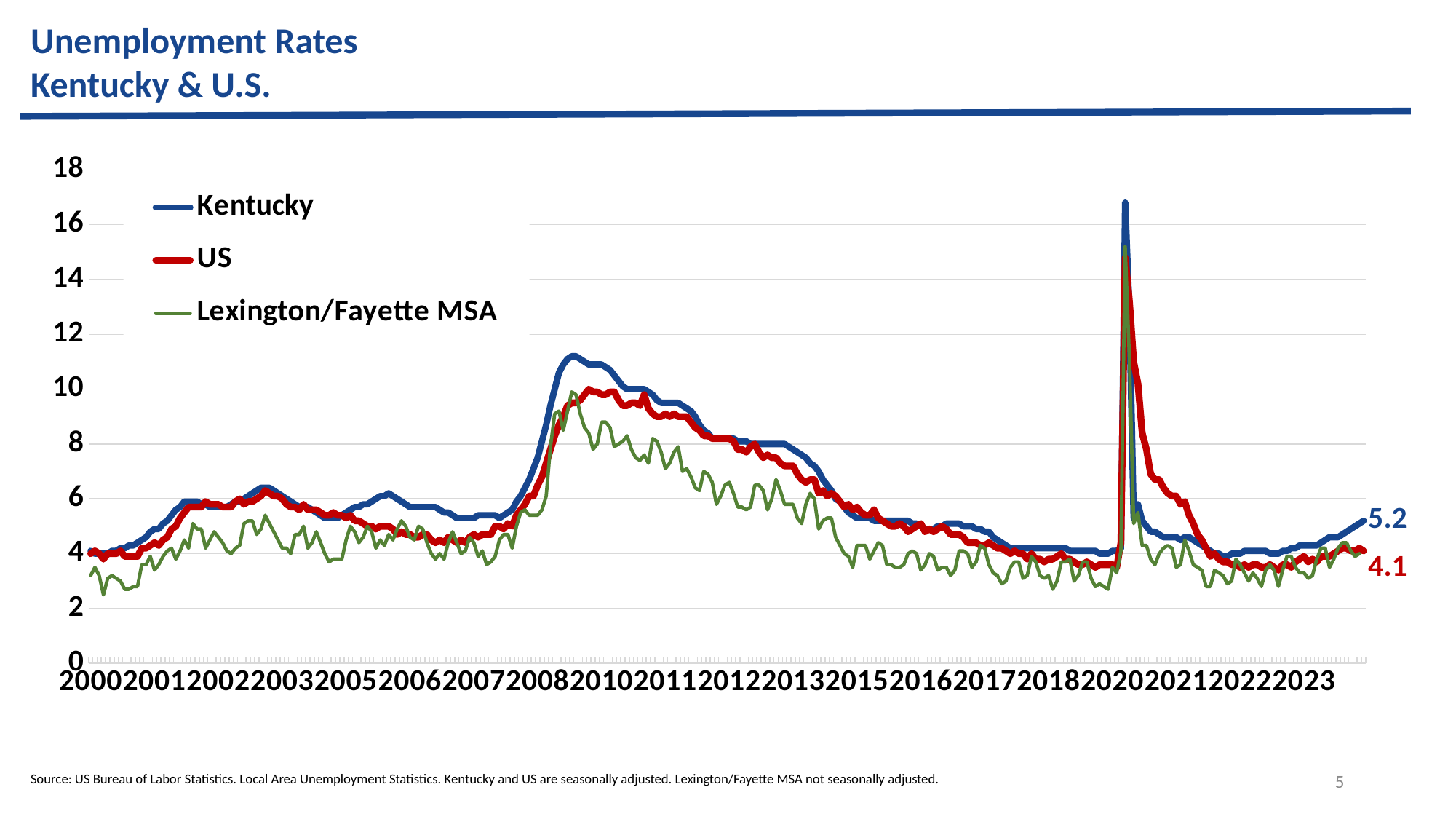
What is the most recent US unemployment rate labelled at the end of the line? 4.1 Is the Kentucky peak in 2020 greater or less than 14? greater What is the most recent Kentucky unemployment rate labelled at the end of the line? 5.2 Is the Lexington/Fayette MSA value at the start of 2000 greater or less than 4? less What is the difference between the latest labelled Kentucky rate and the latest labelled US rate? 1.1 What colour is the Kentucky line? blue What kind of chart is shown on the slide? line chart How many series does the legend list? 3 Which series reaches the highest value anywhere on the chart? Kentucky Does the Kentucky line rise or fall between 2008 and 2009? rise At the end of the series, which is larger: the labelled Kentucky rate or the labelled US rate? Kentucky